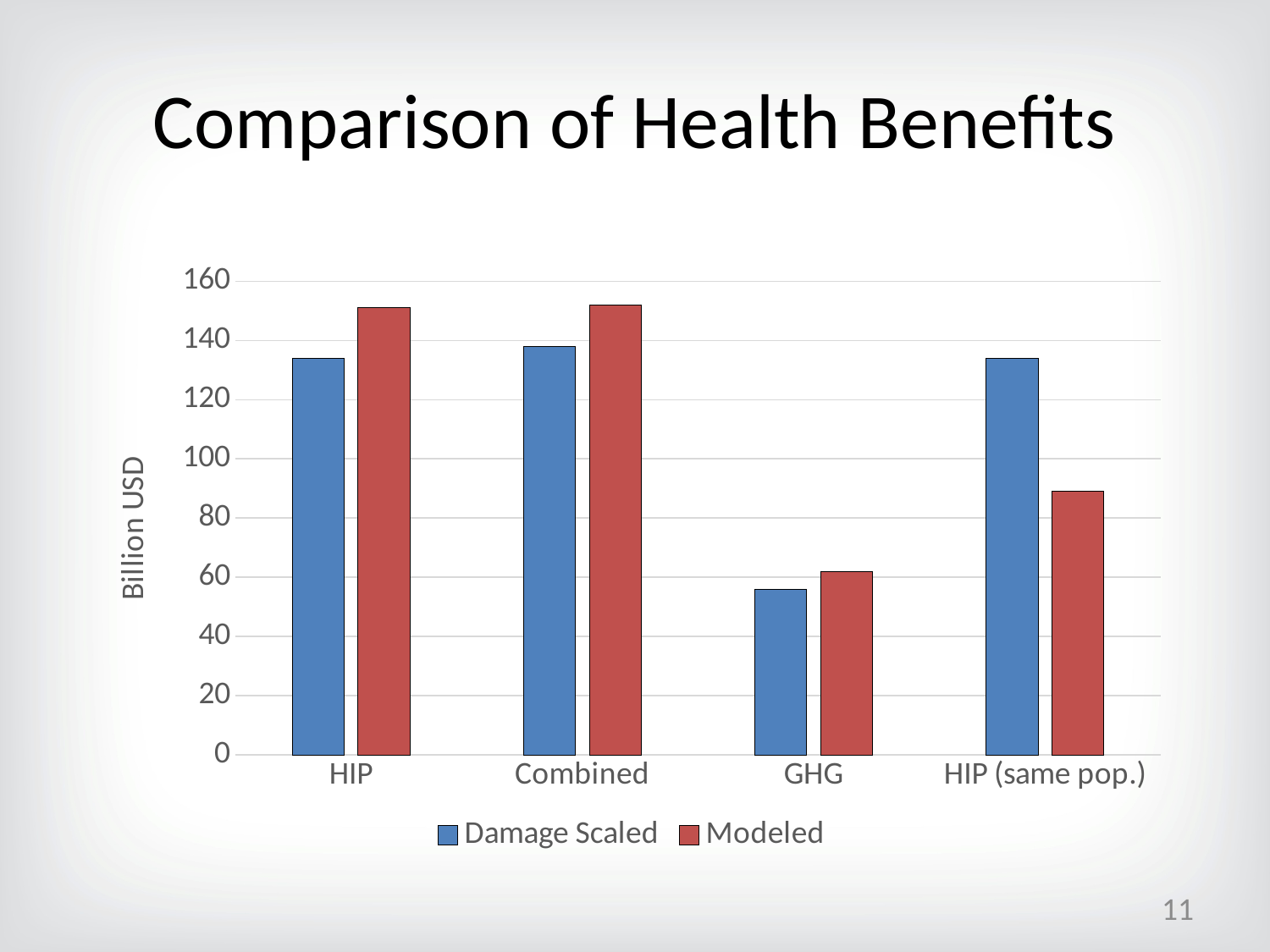
Which category has the lowest Damage Scaled value? GHG Is the Modeled value for HIP (same pop.) greater or less than 100? less Is the Modeled value for HIP greater or less than 140? greater What is the title of the chart on the slide? Comparison of Health Benefits How many series does the legend list? 2 Is the Damage Scaled value for GHG greater or less than 60? less For HIP, which is larger: the Damage Scaled value or the Modeled value? Modeled What is the label of the vertical axis? Billion USD For HIP (same pop.), which is larger: the Damage Scaled value or the Modeled value? Damage Scaled How many categories are shown on the x axis of the chart? 4 Which category has the lowest Modeled value? GHG What kind of chart is shown on the slide? bar chart